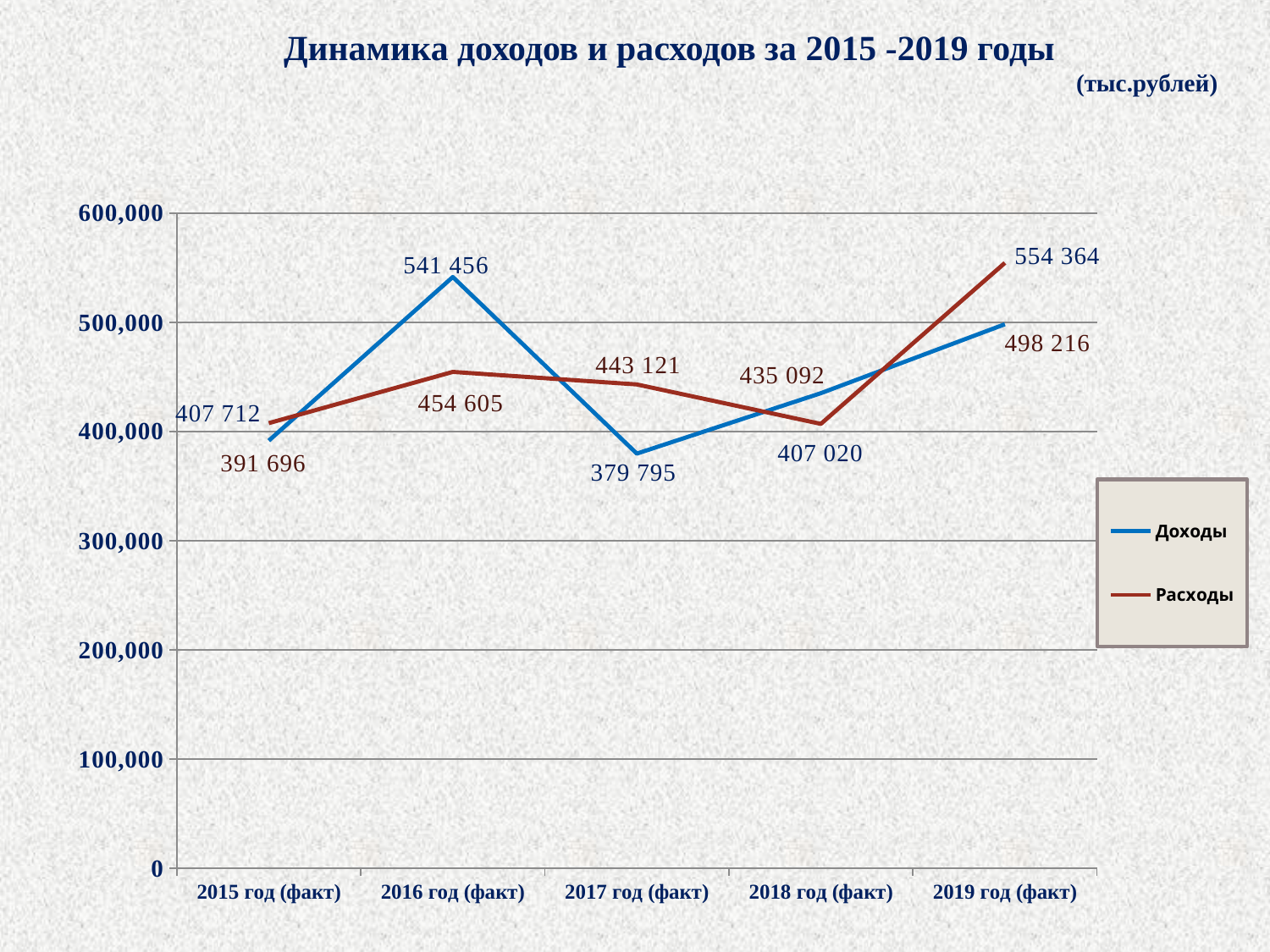
What type of chart is shown on the slide? line chart Which is larger in 2018 год (факт), Доходы or Расходы? Доходы What unit is stated under the chart title? тыс.рублей What is the value of Доходы for 2017 год (факт)? 379 795 In which year is Доходы the highest? 2016 год (факт) How many years are plotted along the x axis? 5 What is the difference between Расходы and Доходы in 2019 год (факт)? 56 148 What is the value of Расходы for 2019 год (факт)? 554 364 What is the value of Доходы for 2016 год (факт)? 541 456 In which year is Доходы the lowest? 2017 год (факт) In which year is Расходы the highest? 2019 год (факт) How many series does the legend list? 2